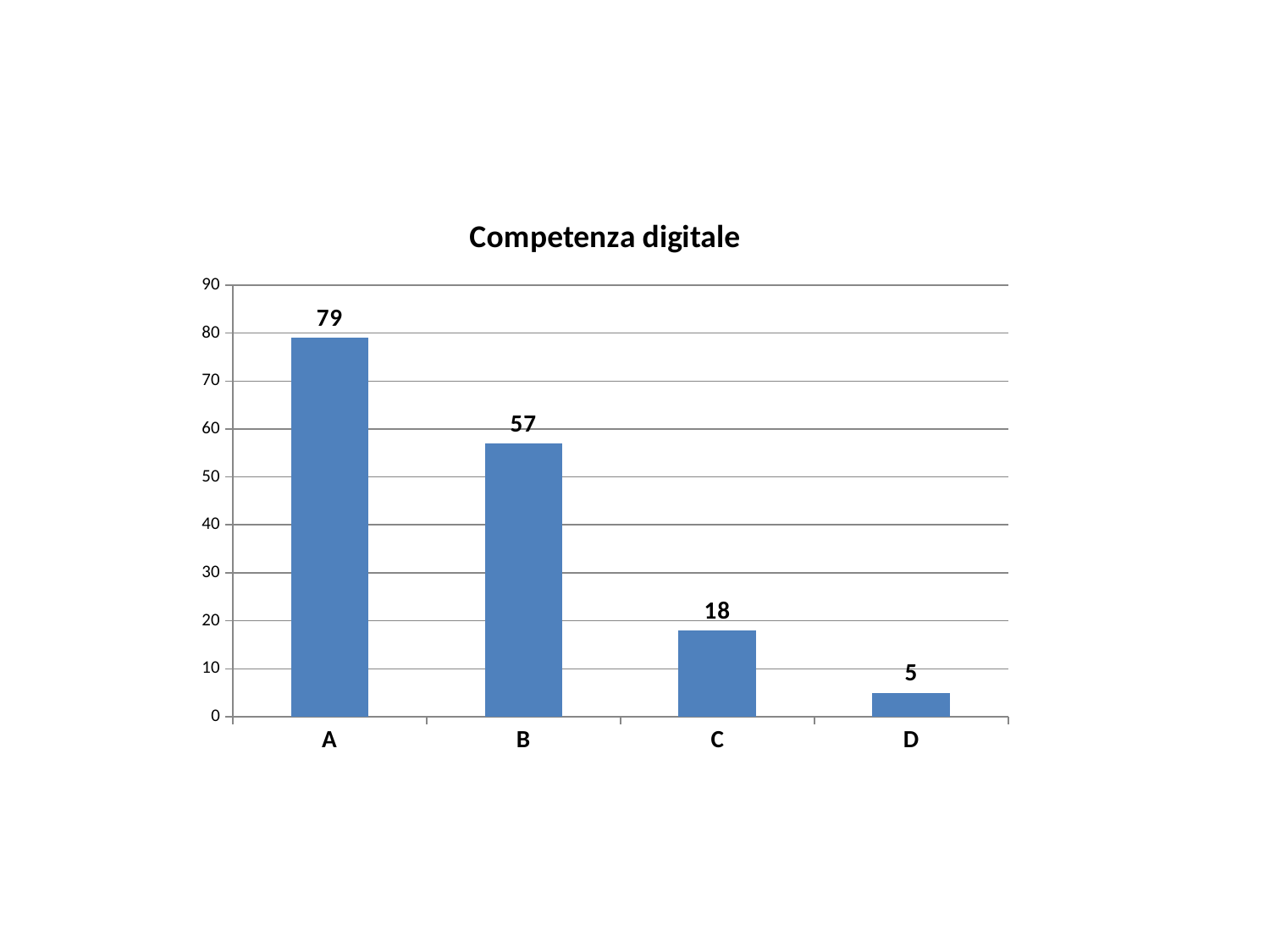
Do the values rise or fall from A to D? fall What kind of chart is this? bar chart What is the value for category D? 5 Which is larger, the value for B or the value for C? B What is the value for category C? 18 Which category has the lowest value? D What is the value for category B? 57 What is the difference between the values for C and D? 13 Which category has the highest value? A How many categories are shown on the x axis? 4 What is the value for category A? 79 What is the difference between the values for A and B? 22